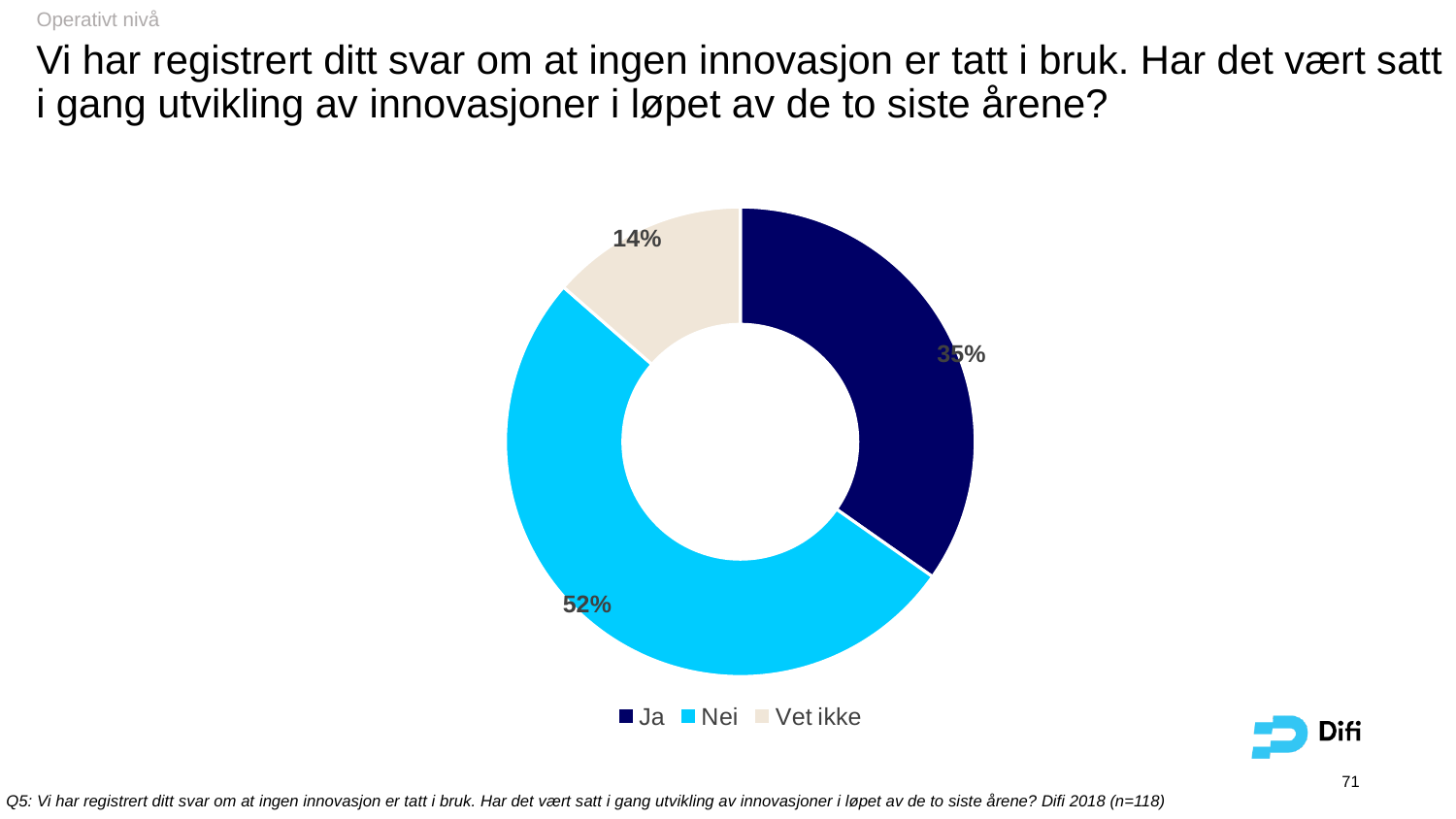
What kind of chart is shown on the slide? Doughnut (pie) chart What is the sample size (n) given in the footnote? 118 Which is larger, the share for "Ja" or the share for "Vet ikke"? Ja What colour is the "Nei" segment in the chart? Light blue What is the difference in percentage points between "Nei" and "Ja"? 17 What percentage of respondents answered "Ja"? 35% Which response category has the smallest share? Vet ikke What percentage of respondents answered "Vet ikke"? 14% What is the difference in percentage points between "Ja" and "Vet ikke"? 21 How many categories does the chart show? 3 Which response category has the largest share? Nei What percentage of respondents answered "Nei"? 52%